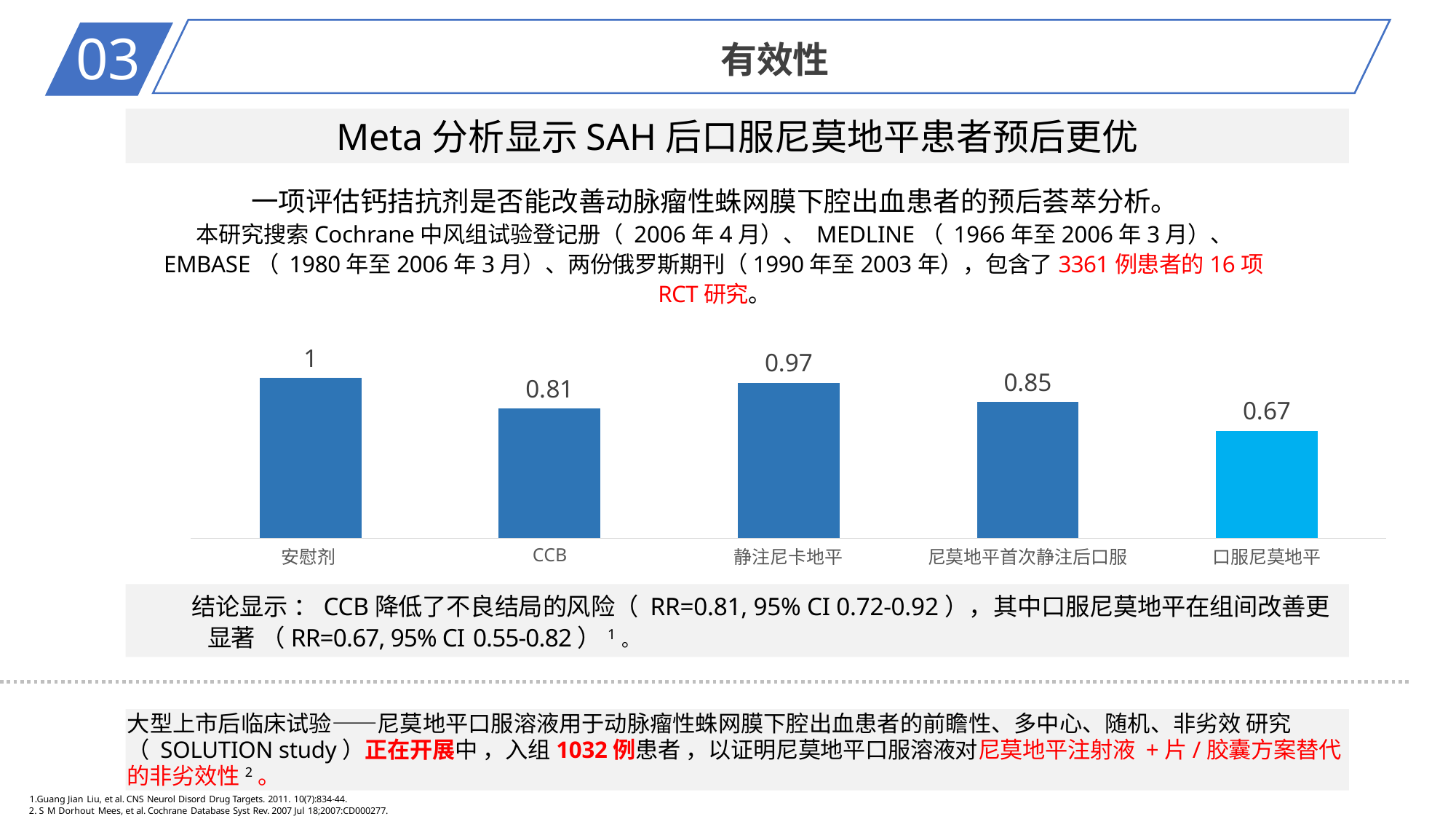
What kind of chart is shown on the slide? Bar chart What is the value shown for 口服尼莫地平? 0.67 Which bar is shown in a lighter blue colour than the others? 口服尼莫地平 How many categories are shown in the chart? 5 Which category has the lowest value? 口服尼莫地平 What is the value shown for CCB? 0.81 Which category has the highest value? 安慰剂 Which is larger, the value for CCB or the value for 尼莫地平首次静注后口服? 尼莫地平首次静注后口服 What is the value shown for 尼莫地平首次静注后口服? 0.85 What is the value shown for 静注尼卡地平? 0.97 What is the value shown for 安慰剂? 1 What is the difference between the values for 安慰剂 and 口服尼莫地平? 0.33